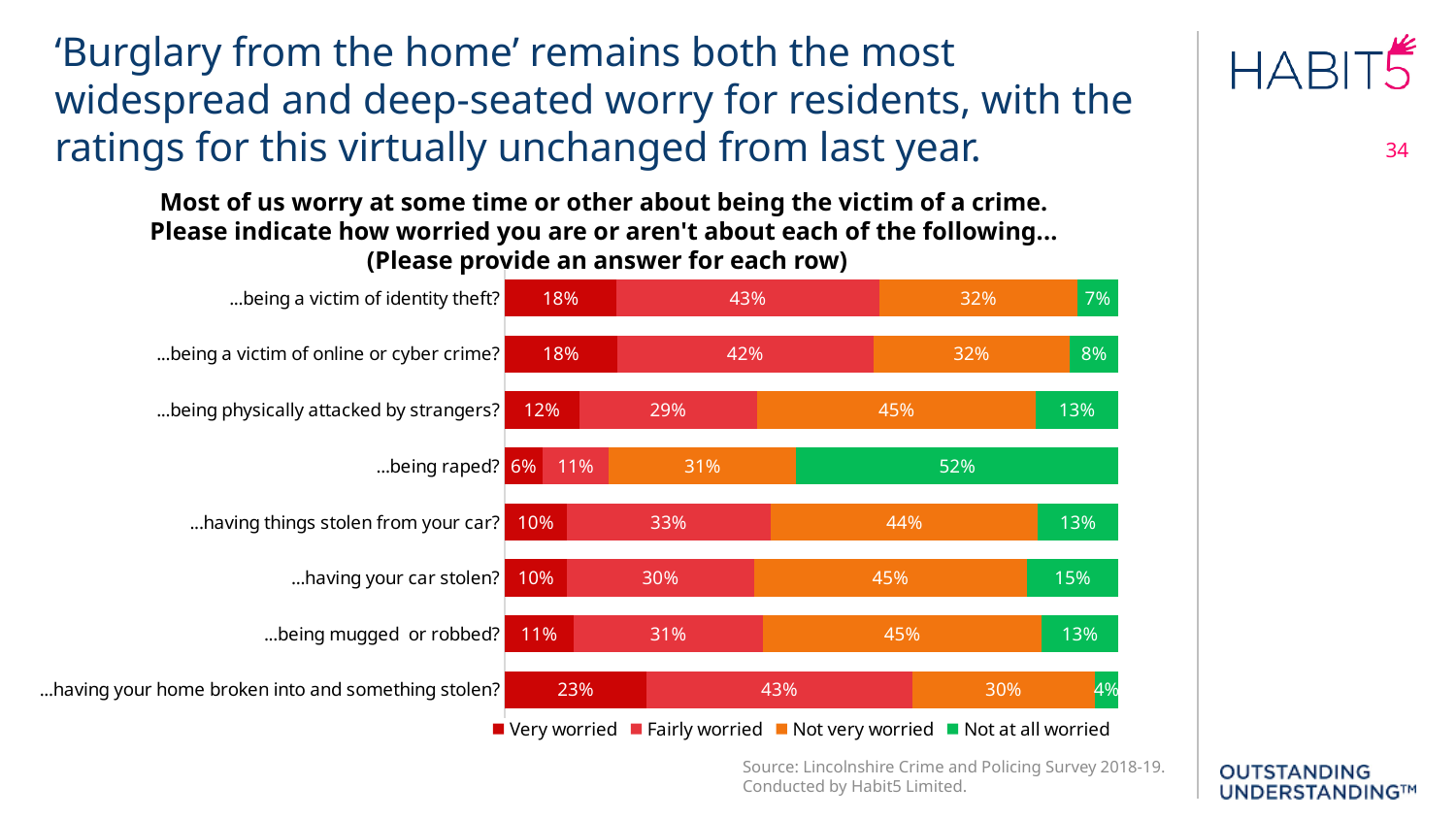
What percentage of respondents are 'Very worried' about having their home broken into and something stolen? 23% What percentage of respondents are 'Not at all worried' about being raped? 52% Which is larger: the 'Not at all worried' value for having your car stolen or for being mugged or robbed? having your car stolen What is the 'Fairly worried' value for being a victim of online or cyber crime? 42% What is the 'Not very worried' value for having things stolen from your car? 44% What is the difference between the 'Very worried' percentages for having your home broken into and something stolen and for being a victim of identity theft? 5% How many series does the legend list? 4 How many categories (rows) are shown in the chart? 8 Which category has the highest 'Very worried' percentage? ...having your home broken into and something stolen? What kind of chart is shown on the slide? Stacked bar chart What is the total of the stacked bar for being a victim of identity theft? 100% Which category has the lowest 'Very worried' percentage? ...being raped?